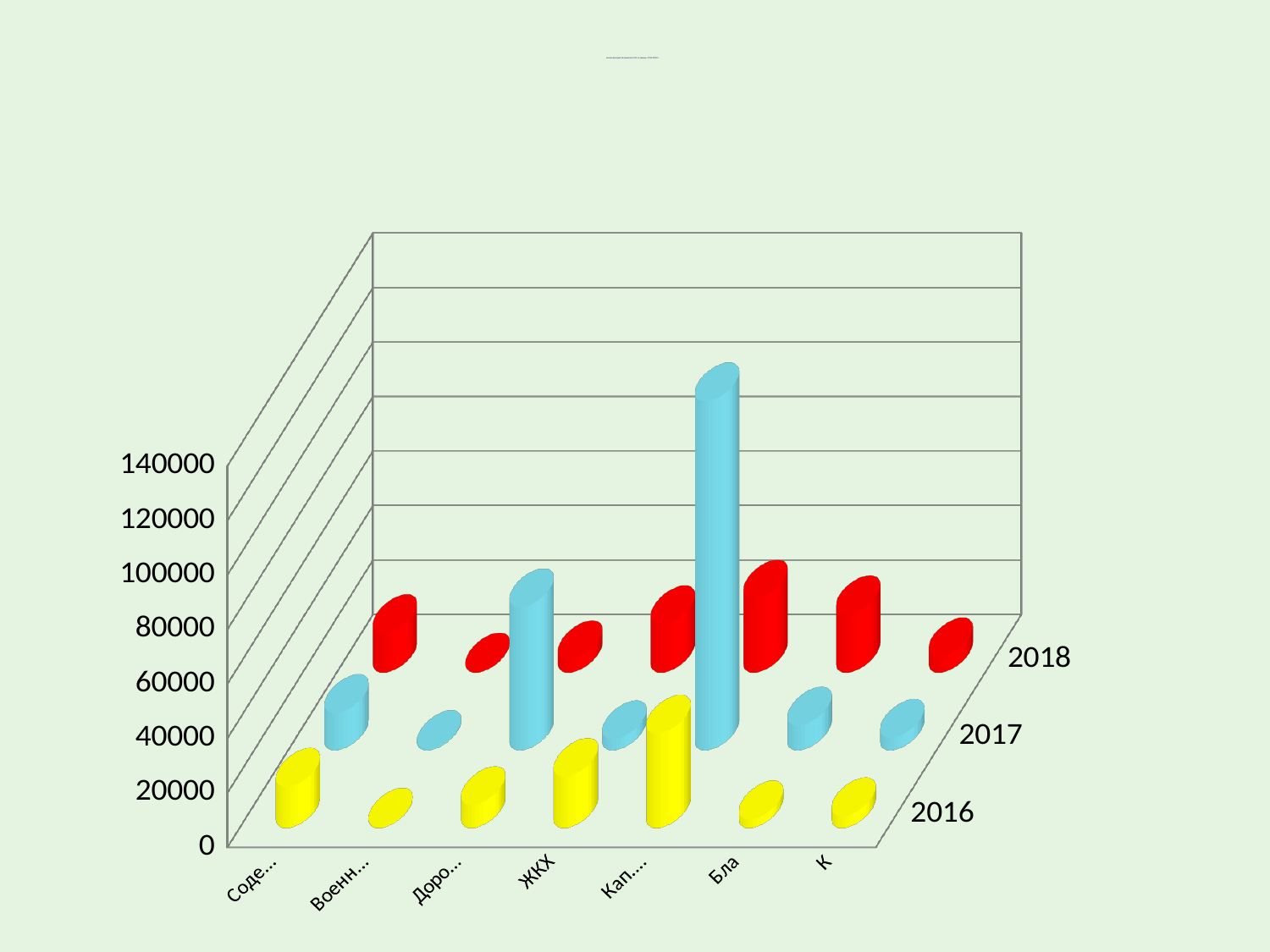
How many years (series) are plotted in the chart? 3 How many categories are shown along the horizontal axis of the chart? 7 What is the highest value labelled on the vertical axis? 140000 For 2017, which is larger: the value for Бла or the value for ЖКХ? Бла What kind of chart is shown on the slide? bar chart Which category has the tallest bar in the chart? Кап.... For which year is the tallest bar in the chart plotted? 2017 What colour are the bars for the 2016 series? yellow Is the 2017 value for Бла greater or less than 100000? less Which years are plotted as series in the chart? 2016, 2017, 2018 Is the 2017 value for ЖКХ greater or less than 100000? less